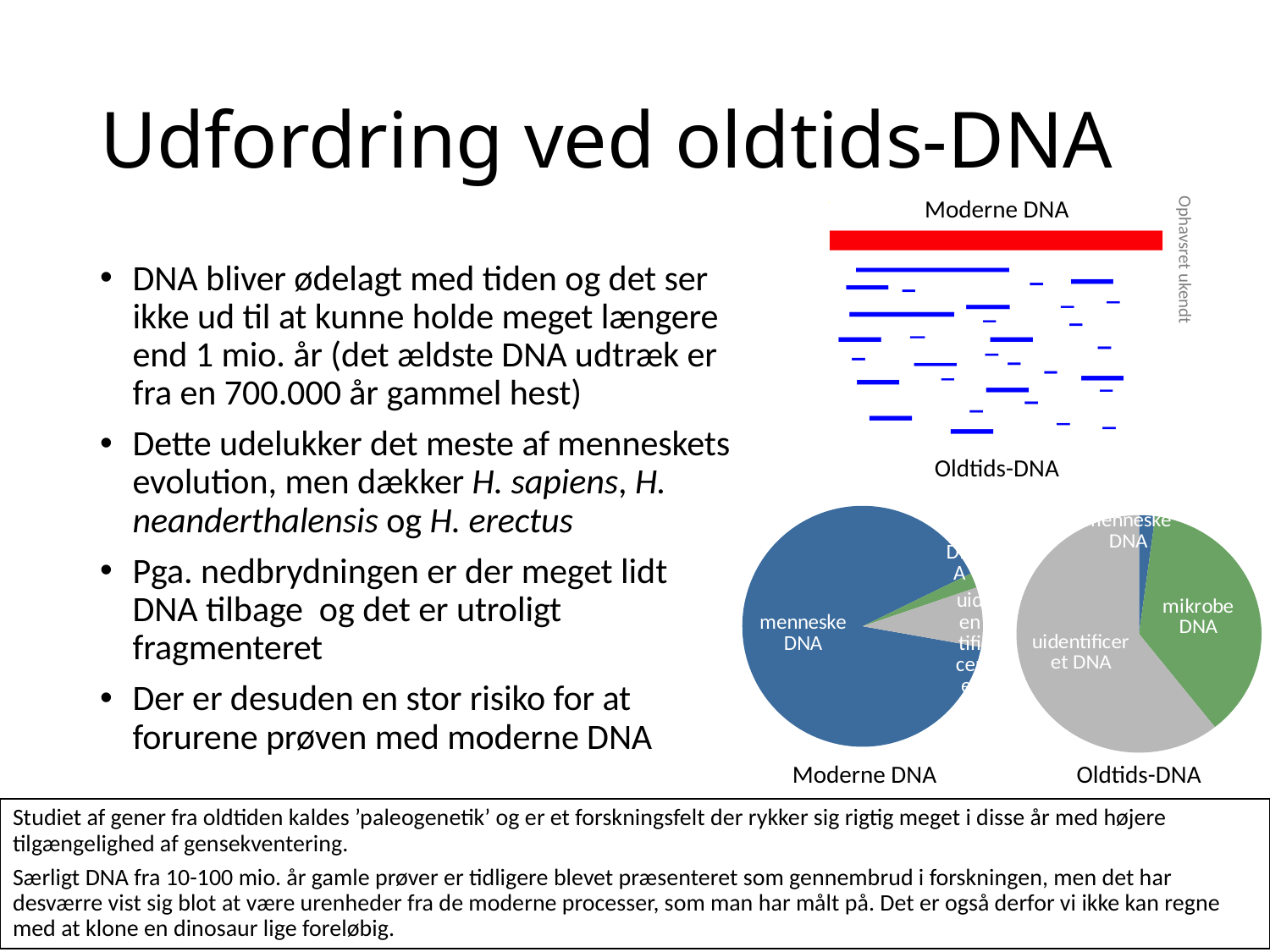
What kind of chart is the "Moderne DNA" chart at the bottom of the slide? pie chart How many pie charts are shown on the slide? 2 In the "Oldtids-DNA" pie chart, what colour is the uidentificeret DNA slice? grey How many slices does the "Oldtids-DNA" pie chart have? 3 In the "Oldtids-DNA" pie chart, which category takes up the largest slice? uidentificeret DNA In the "Oldtids-DNA" pie chart, which category takes up the smallest slice? menneske DNA In the "Oldtids-DNA" pie chart, which slice is larger: mikrobe DNA or menneske DNA? mikrobe DNA In the "Oldtids-DNA" pie chart, which slice is larger: uidentificeret DNA or mikrobe DNA? uidentificeret DNA What kind of chart is the "Oldtids-DNA" chart at the bottom right of the slide? pie chart In the "Oldtids-DNA" pie chart, what colour is the mikrobe DNA slice? green In the "Moderne DNA" pie chart, which slice is larger: menneske DNA or mikrobe DNA? menneske DNA In the "Moderne DNA" pie chart, which category takes up the largest slice? menneske DNA